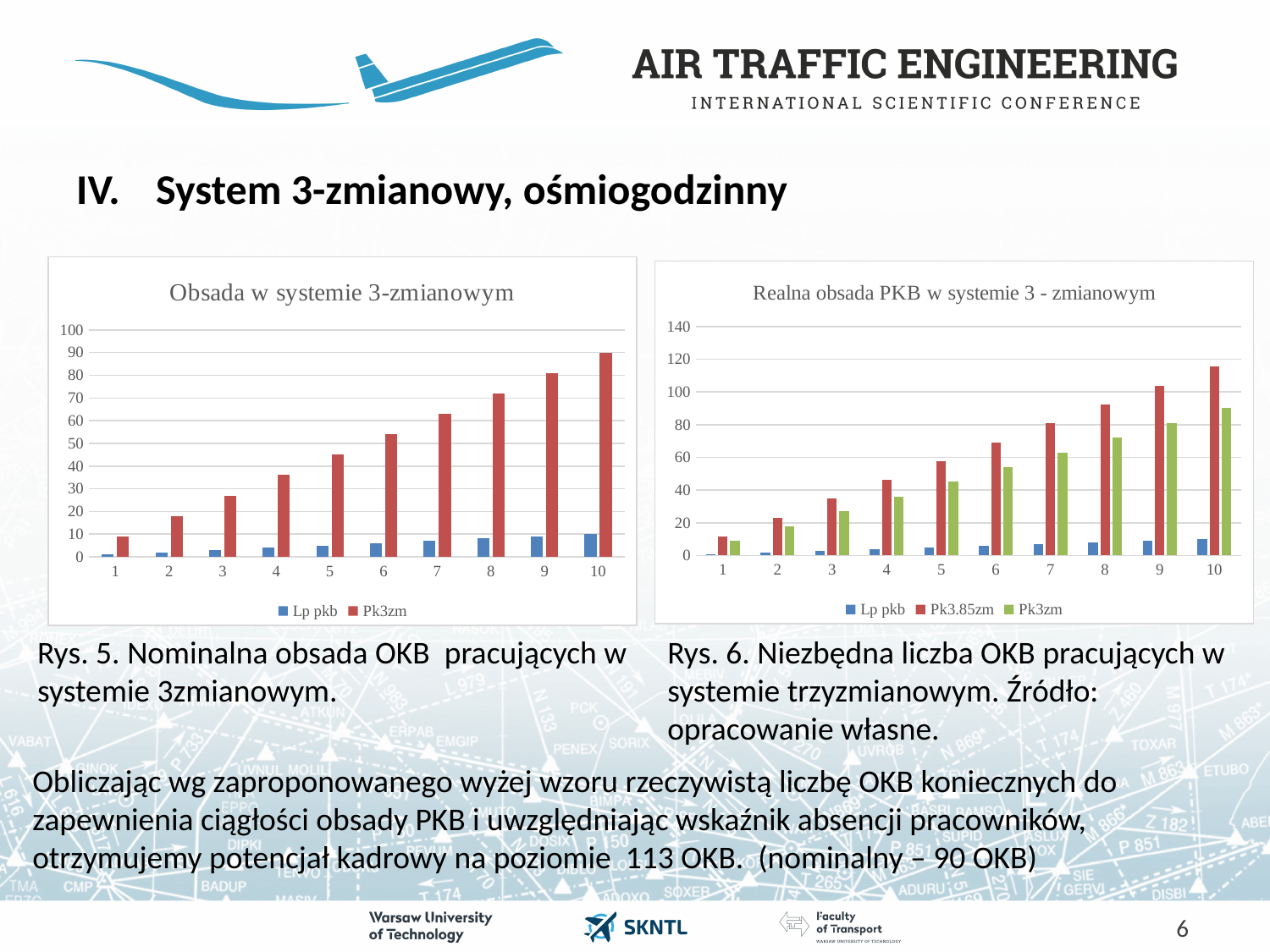
What type of chart is the left chart titled "Obsada w systemie 3-zmianowym"? bar chart How many categories are shown on the x axis of the left chart "Obsada w systemie 3-zmianowym"? 10 In the right chart "Realna obsada PKB w systemie 3 - zmianowym", is the Pk3zm value for category 5 greater or less than 60? less In the left chart "Obsada w systemie 3-zmianowym", which category has the highest Pk3zm value? 10 In the left chart "Obsada w systemie 3-zmianowym", what is the Pk3zm value for category 10? 90 How many series does the legend of the left chart "Obsada w systemie 3-zmianowym" list? 2 In the right chart "Realna obsada PKB w systemie 3 - zmianowym", which category has the lowest Pk3.85zm value? 1 In the right chart "Realna obsada PKB w systemie 3 - zmianowym", is the Pk3.85zm value for category 10 greater or less than 100? greater How many series does the legend of the right chart "Realna obsada PKB w systemie 3 - zmianowym" list? 3 In the left chart "Obsada w systemie 3-zmianowym", do the Pk3zm values rise or fall from category 1 to category 10? rise In the right chart "Realna obsada PKB w systemie 3 - zmianowym", which series has the larger value for category 8: Pk3.85zm or Pk3zm? Pk3.85zm In the left chart "Obsada w systemie 3-zmianowym", what is the Lp pkb value for category 10? 10